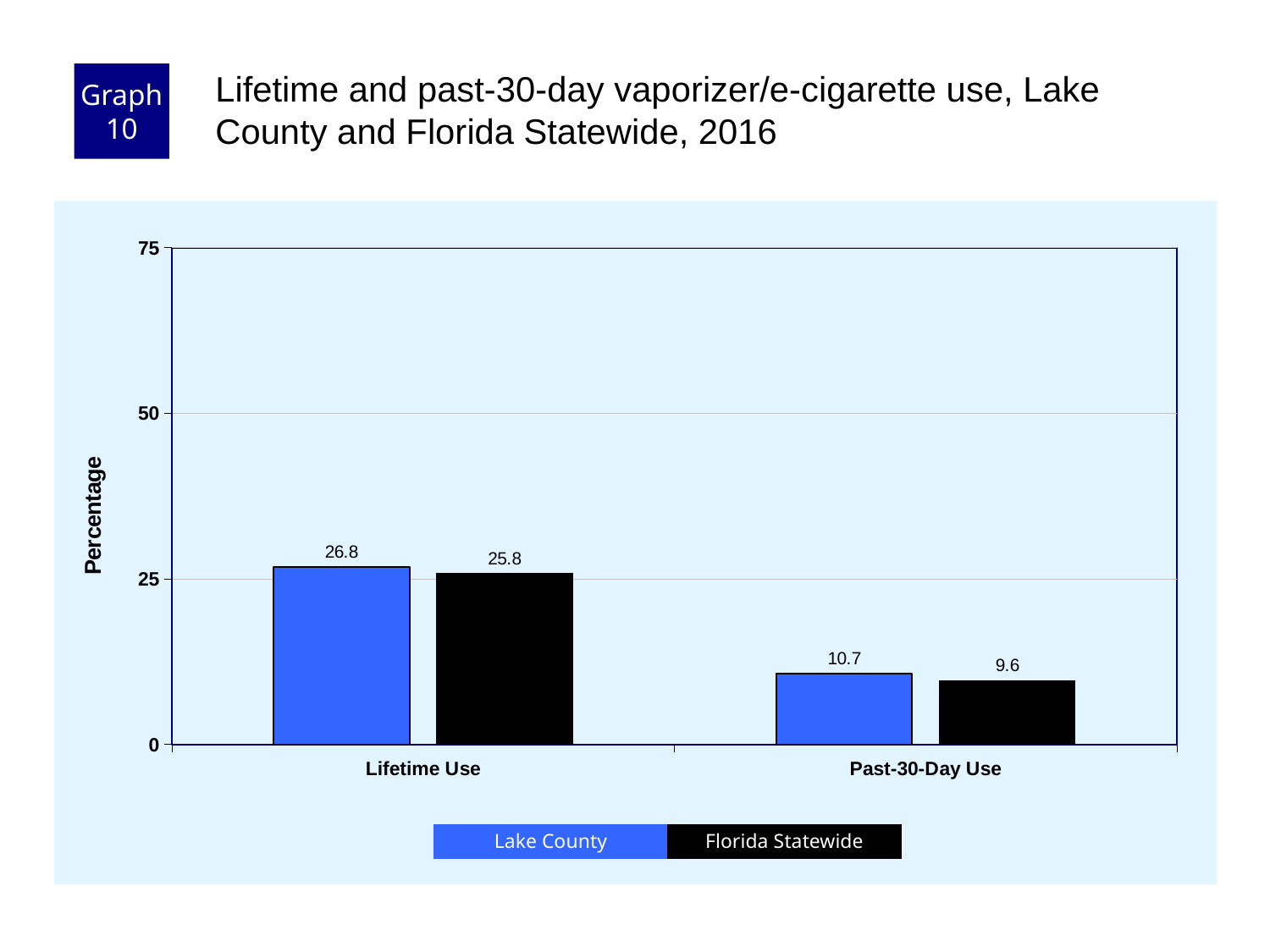
What kind of chart is shown on the slide? bar chart Which bar has the lowest value on the chart? Florida Statewide, Past-30-Day Use Is the Lake County value for Lifetime Use greater or less than 25? greater What is the Lake County value for Lifetime Use? 26.8 What is the difference between the Lake County and Florida Statewide values for Past-30-Day Use? 1.1 Which bar has the highest value on the chart? Lake County, Lifetime Use What is the Lake County value for Past-30-Day Use? 10.7 What is the difference between the Lake County and Florida Statewide values for Lifetime Use? 1.0 What is the label on the vertical axis? Percentage What is the Florida Statewide value for Past-30-Day Use? 9.6 What is the Florida Statewide value for Lifetime Use? 25.8 How many series does the legend list? 2